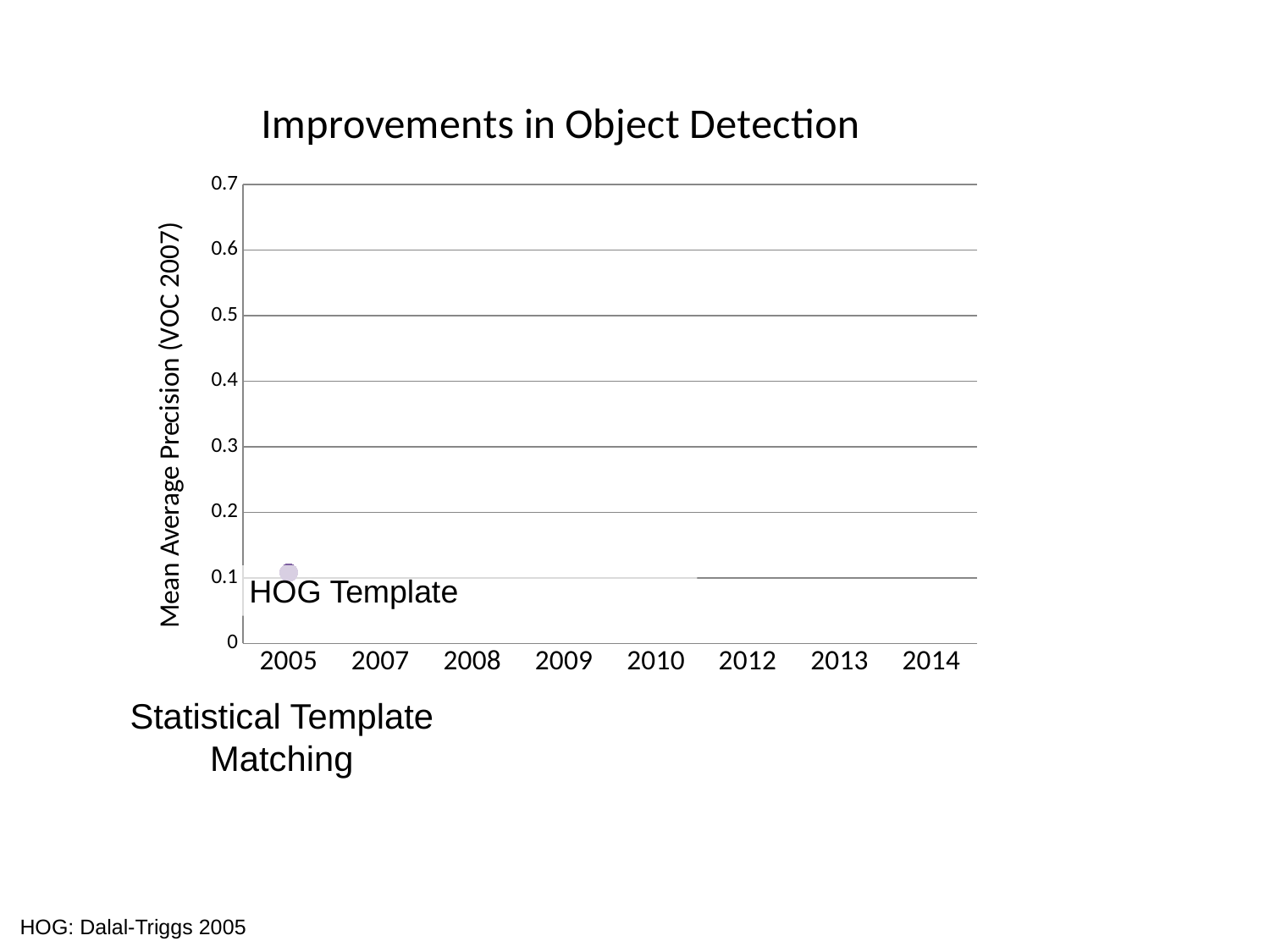
What is the highest value shown on the vertical axis of the chart? 0.7 How many data points are plotted on the chart? 1 How many year labels are shown along the x axis of the chart? 8 What is the title of the chart? Improvements in Object Detection Is the value plotted for 2005 greater or less than 0.5? less What is the last year label on the x axis of the chart? 2014 Is the value plotted for 2005 greater or less than 0.2? less What is the label on the vertical axis of the chart? Mean Average Precision (VOC 2007) For which year is a data point plotted on the chart? 2005 What is the first year label on the x axis of the chart? 2005